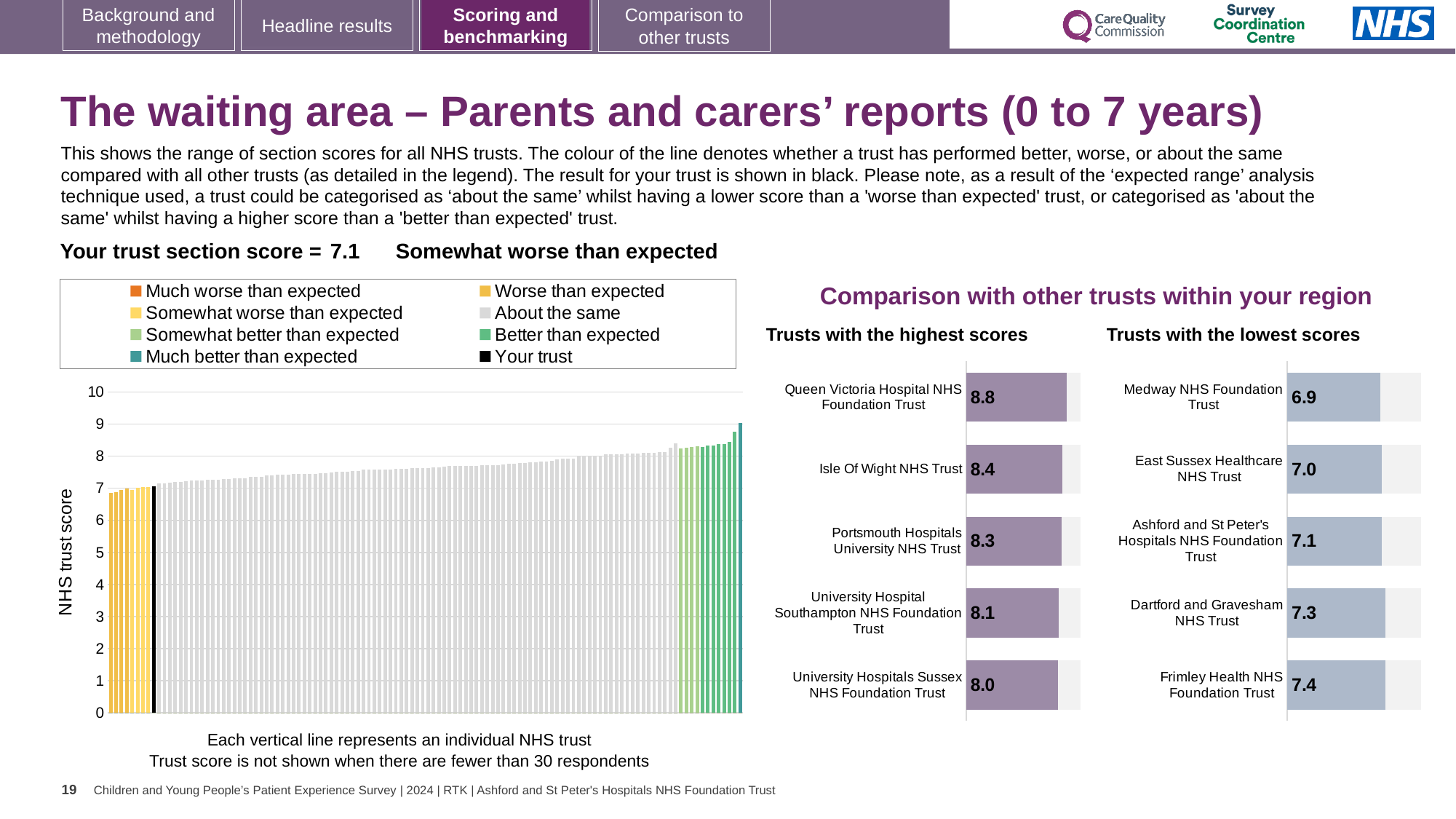
In the 'Trusts with the highest scores' chart, what is the score for University Hospital Southampton NHS Foundation Trust? 8.1 In the 'Trusts with the lowest scores' chart, which has the larger score: East Sussex Healthcare NHS Trust or Frimley Health NHS Foundation Trust? Frimley Health NHS Foundation Trust In the 'Trusts with the highest scores' chart, which trust has the lowest score? University Hospitals Sussex NHS Foundation Trust How many trusts are shown in the 'Trusts with the lowest scores' chart? 5 In the 'Trusts with the highest scores' chart, what is the difference between the scores of Queen Victoria Hospital NHS Foundation Trust and University Hospitals Sussex NHS Foundation Trust? 0.8 In the large chart on the left showing all NHS trusts, do the scores rise or fall from left to right? rise In the 'Trusts with the lowest scores' chart, what is the score for Dartford and Gravesham NHS Trust? 7.3 In the 'Trusts with the highest scores' chart, what is the score for Queen Victoria Hospital NHS Foundation Trust? 8.8 What is the y-axis label of the large chart on the left? NHS trust score In the 'Trusts with the lowest scores' chart, what is the score for Medway NHS Foundation Trust? 6.9 How many entries does the legend of the large chart on the left list? 8 In the 'Trusts with the lowest scores' chart, which trust has the highest score? Frimley Health NHS Foundation Trust